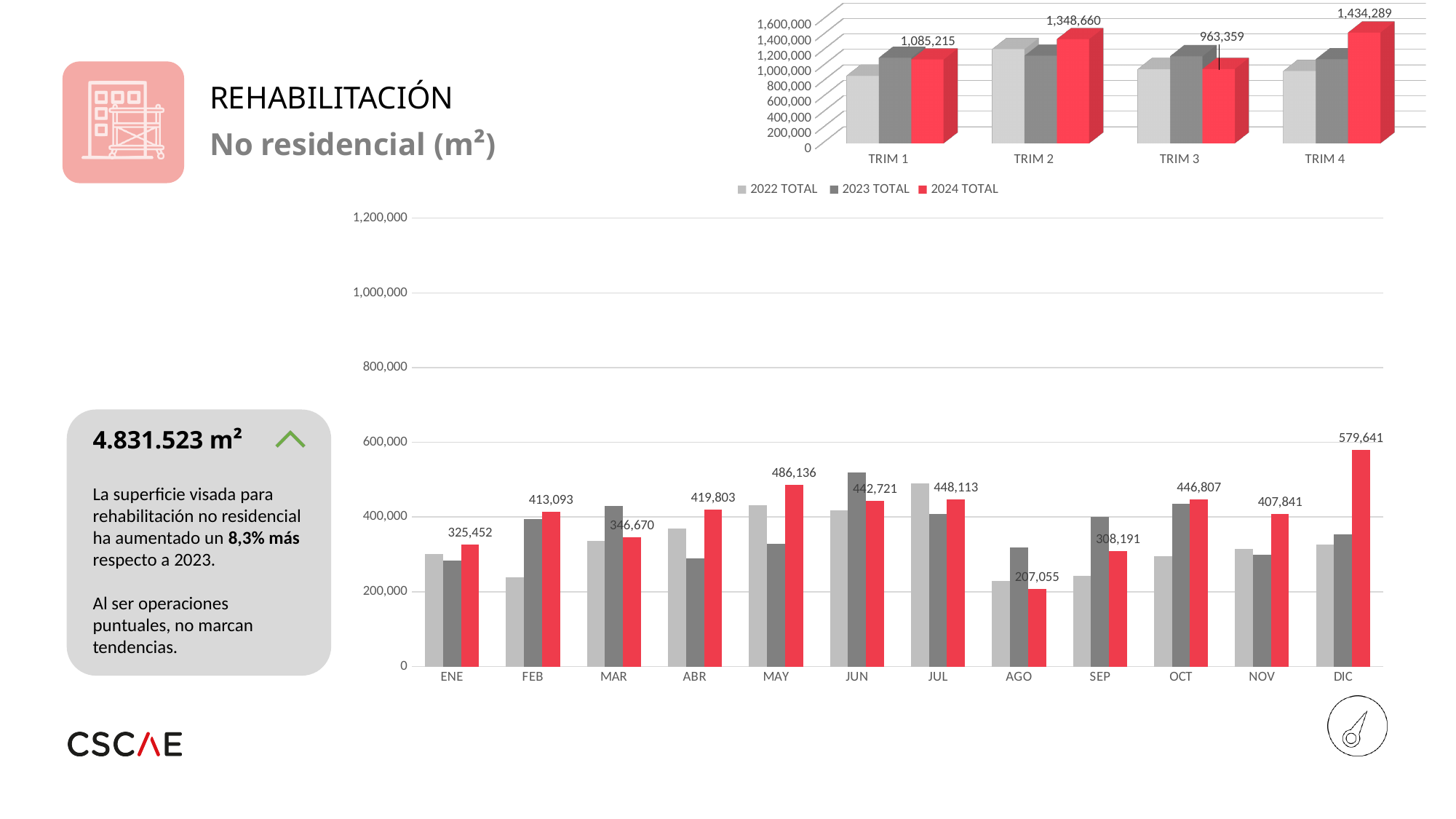
In the monthly chart at the bottom, what is the difference between the labelled values for DIC and AGO? 372,586 In the monthly chart at the bottom, what is the labelled value for AGO? 207,055 In the quarterly chart at the top right, which quarter has the highest 2024 TOTAL value? TRIM 4 How many series does the legend of the quarterly chart at the top right list? 3 In the monthly chart at the bottom, what is the labelled value for DIC? 579,641 In the monthly chart at the bottom, which labelled value is larger, MAY or JUN? MAY How many months are shown on the x axis of the monthly chart at the bottom? 12 In the quarterly chart at the top right, what is the 2024 TOTAL value for TRIM 2? 1,348,660 In the monthly chart at the bottom, which month has the lowest labelled value? AGO In the monthly chart at the bottom, is the value of the light grey bar for JUL greater or less than 400,000? greater In the quarterly chart at the top right, which quarter has the lowest 2024 TOTAL value? TRIM 3 In the quarterly chart at the top right, what is the difference between the 2024 TOTAL values for TRIM 4 and TRIM 3? 470,930